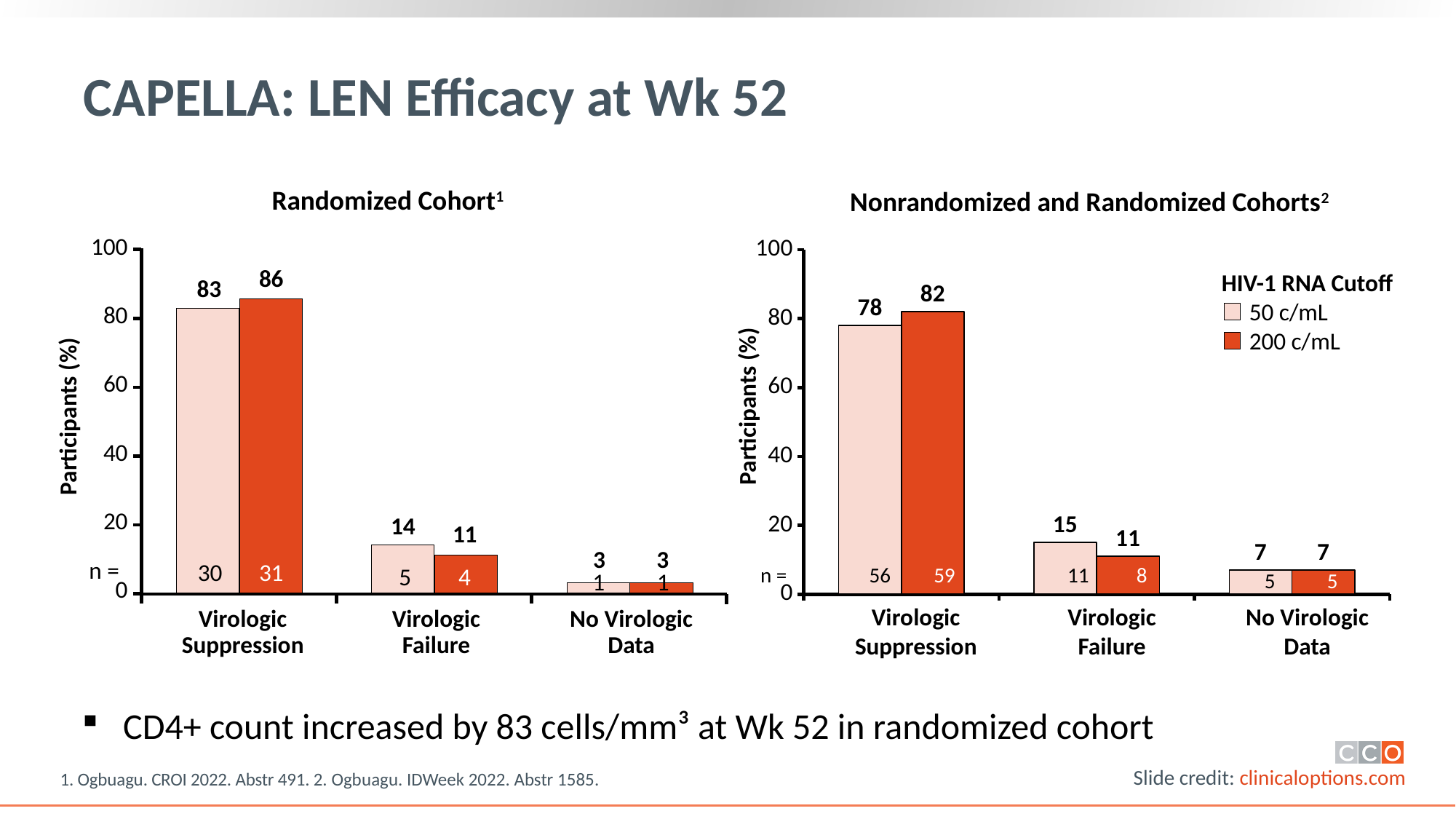
In the Randomized Cohort chart, what is the difference in virologic suppression percentage between the 200 c/mL and 50 c/mL cutoffs? 3 In the Nonrandomized and Randomized Cohorts chart, what is the n for virologic failure at the 50 c/mL cutoff? 11 In the Randomized Cohort chart, what percentage of participants achieved virologic suppression at the 50 c/mL cutoff? 83 How many series does the HIV-1 RNA Cutoff legend list? 2 In the Randomized Cohort chart, is the value for virologic suppression at 50 c/mL greater or less than 80? greater In the Randomized Cohort chart, what percentage of participants had virologic failure at the 200 c/mL cutoff? 11 How many categories are shown on the x axis of the Nonrandomized and Randomized Cohorts chart? 3 In the Randomized Cohort chart, which category has the highest percentage for the 200 c/mL cutoff? Virologic Suppression In the Nonrandomized and Randomized Cohorts chart, which cutoff has the larger virologic failure percentage, 50 c/mL or 200 c/mL? 50 c/mL In the Nonrandomized and Randomized Cohorts chart, which category has the lowest percentage for the 50 c/mL cutoff? No Virologic Data What type of chart is the Randomized Cohort chart? Bar chart In the Nonrandomized and Randomized Cohorts chart, what percentage of participants achieved virologic suppression at the 200 c/mL cutoff? 82